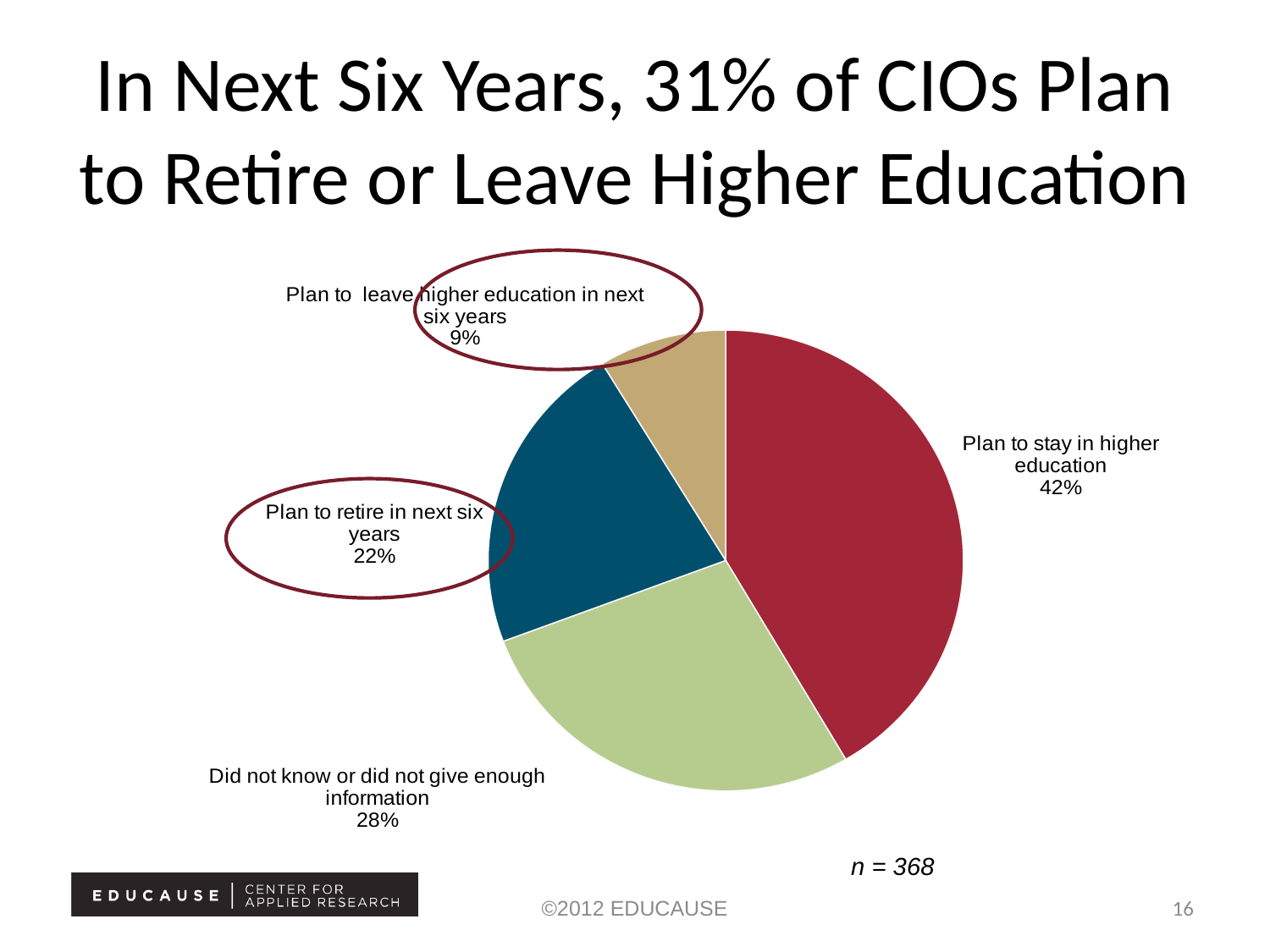
How many slices does the pie chart have? 4 What percentage of CIOs plan to leave higher education in the next six years? 9% What is the difference in percentage points between 'Plan to stay in higher education' and 'Plan to retire in next six years'? 20 What kind of chart is shown on the slide? pie chart Which is larger: 'Did not know or did not give enough information' or 'Plan to retire in next six years'? Did not know or did not give enough information What percentage of CIOs plan to stay in higher education? 42% What is the combined percentage of CIOs who plan to retire or leave higher education in the next six years? 31% Which category has the largest share of the pie? Plan to stay in higher education What is the sample size (n) shown on the slide? n = 368 What percentage of CIOs did not know or did not give enough information? 28% Which category has the smallest share of the pie? Plan to leave higher education in next six years What percentage of CIOs plan to retire in the next six years? 22%